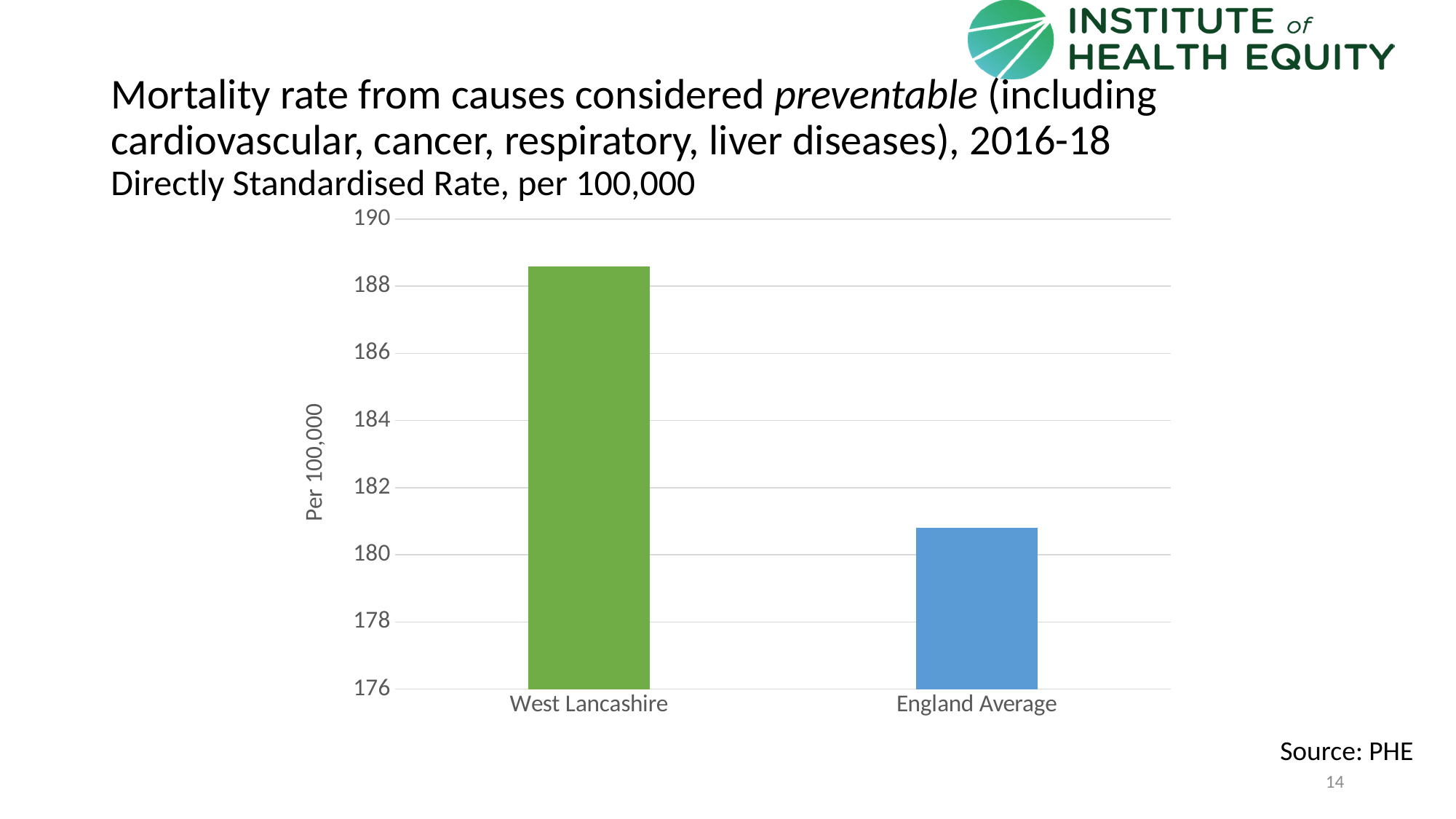
Which is larger, the value for West Lancashire or the value for England Average? West Lancashire Is the value for England Average greater or less than 180? greater Which category has the highest mortality rate? West Lancashire What is the label on the vertical axis of the chart? Per 100,000 Is the value for England Average greater or less than 182? less Is the value for West Lancashire greater or less than 188? greater How many categories are plotted in the chart? 2 What kind of chart is shown on the slide? bar chart Which category has the lowest mortality rate? England Average What colour is the bar for West Lancashire? green